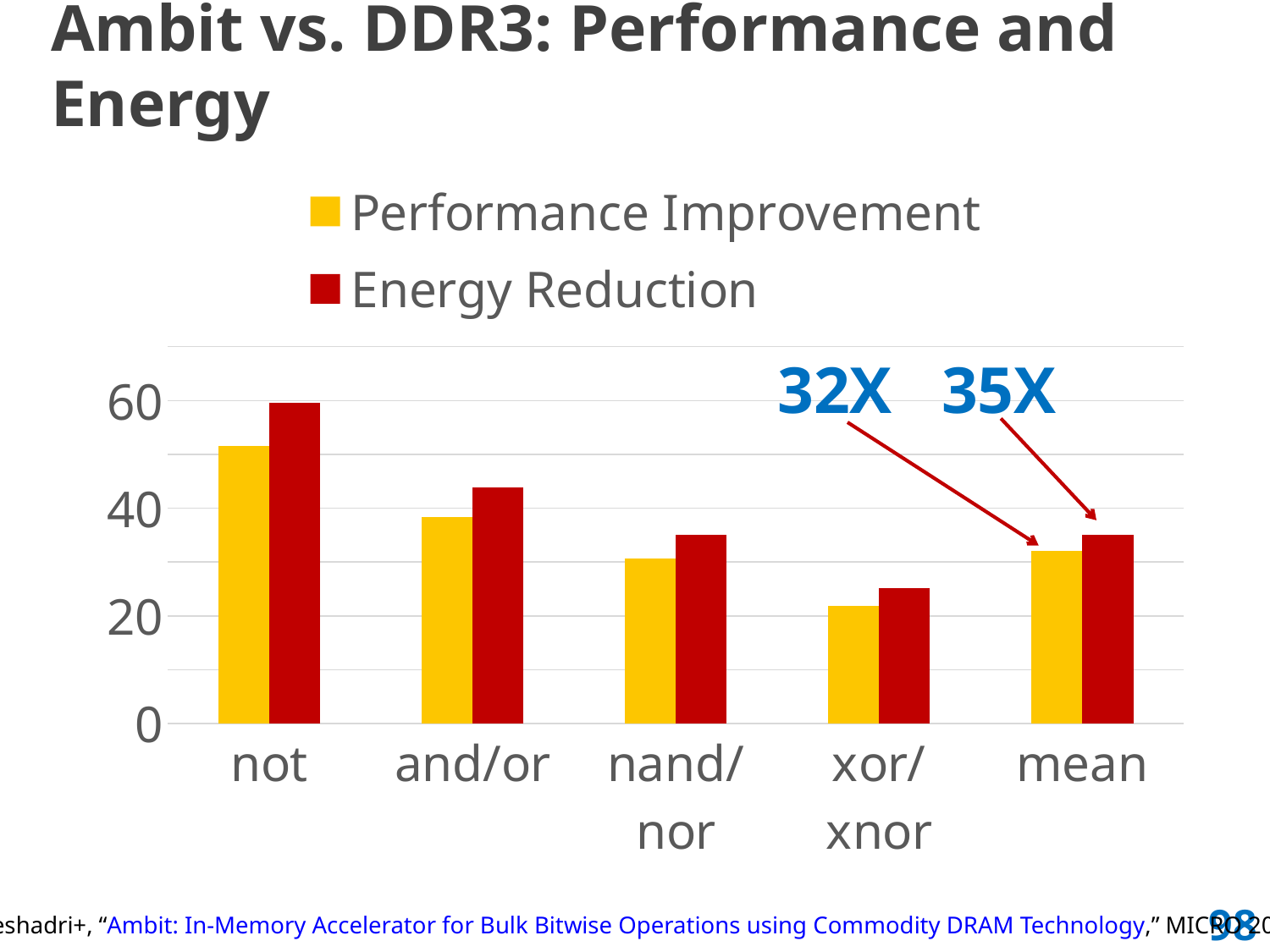
What is the Performance Improvement value for mean? 32X What is the difference between the Energy Reduction and Performance Improvement values for mean? 3X Is the Energy Reduction value for xor/xnor greater or less than 40? less How many categories are shown on the x axis? 5 What kind of chart is shown on the slide? bar chart For the not category, which is larger: Performance Improvement or Energy Reduction? Energy Reduction What is the Energy Reduction value for mean? 35X How many series does the legend list? 2 Which category has the lowest Performance Improvement? xor/xnor Is the Performance Improvement value for not greater or less than 40? greater Which category has the highest Energy Reduction? not Which colour represents Energy Reduction in the legend? red